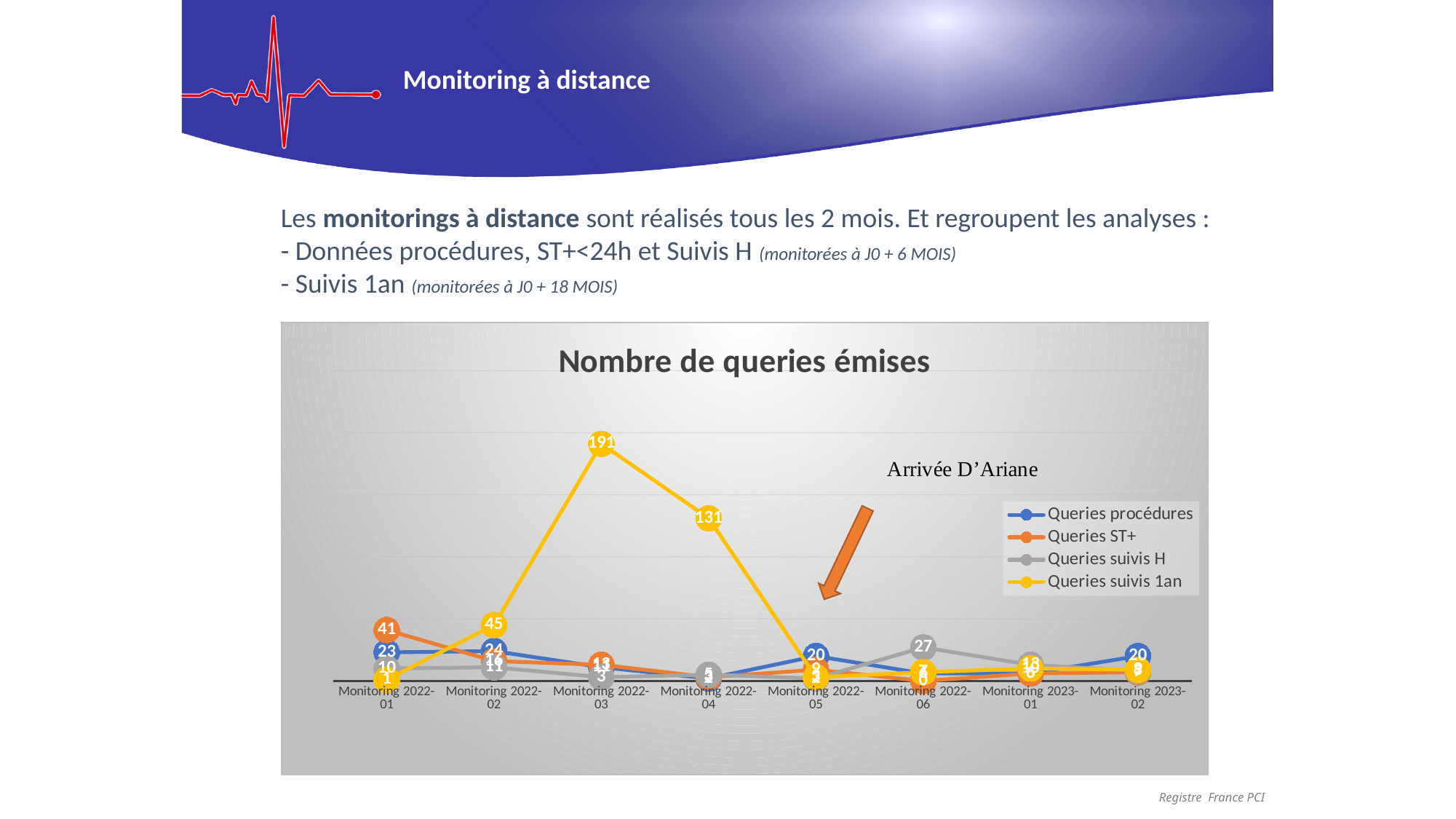
What is the value of Queries suivis 1an at Monitoring 2022-04? 131 How many series does the legend of the chart list? 4 What kind of chart is shown on the slide? line chart What is the value of Queries ST+ at Monitoring 2022-01? 41 What is the value of Queries suivis H at Monitoring 2022-06? 27 What is the value of Queries suivis 1an at Monitoring 2022-03? 191 At which monitoring period does Queries suivis 1an reach its highest value? Monitoring 2022-03 At Monitoring 2022-01, which is larger: Queries ST+ or Queries procédures? Queries ST+ How many monitoring periods are shown along the x axis of the chart? 8 What is the difference between the Queries suivis 1an values at Monitoring 2022-03 and Monitoring 2022-04? 60 What is the title of the chart? Nombre de queries émises What is the value of Queries suivis 1an at Monitoring 2022-02? 45